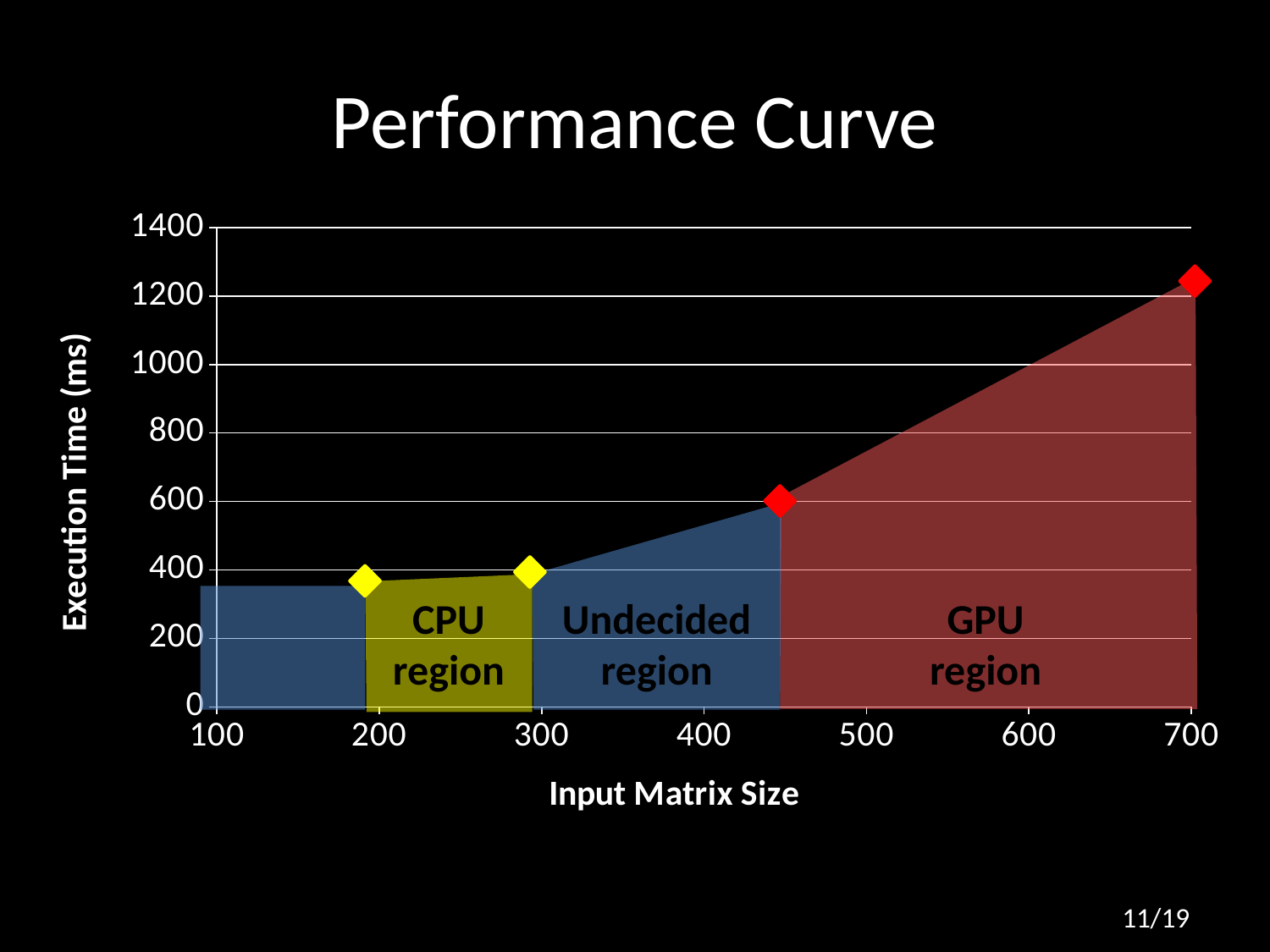
Is the execution time at input matrix size 100 greater or less than 400? less What type of chart is shown on the slide? area chart Is the execution time at input matrix size 300 greater or less than 600? less Does execution time rise or fall as input matrix size increases from 300 to 700? rise Which has the larger execution time: input matrix size 200 or input matrix size 700? 700 At which input matrix size shown on the x axis is the execution time highest? 700 What is the title of the chart? Performance Curve Is the execution time at input matrix size 600 greater or less than 800? greater How many labeled regions are marked on the chart? 3 Which region of the chart is shaded yellow? CPU region